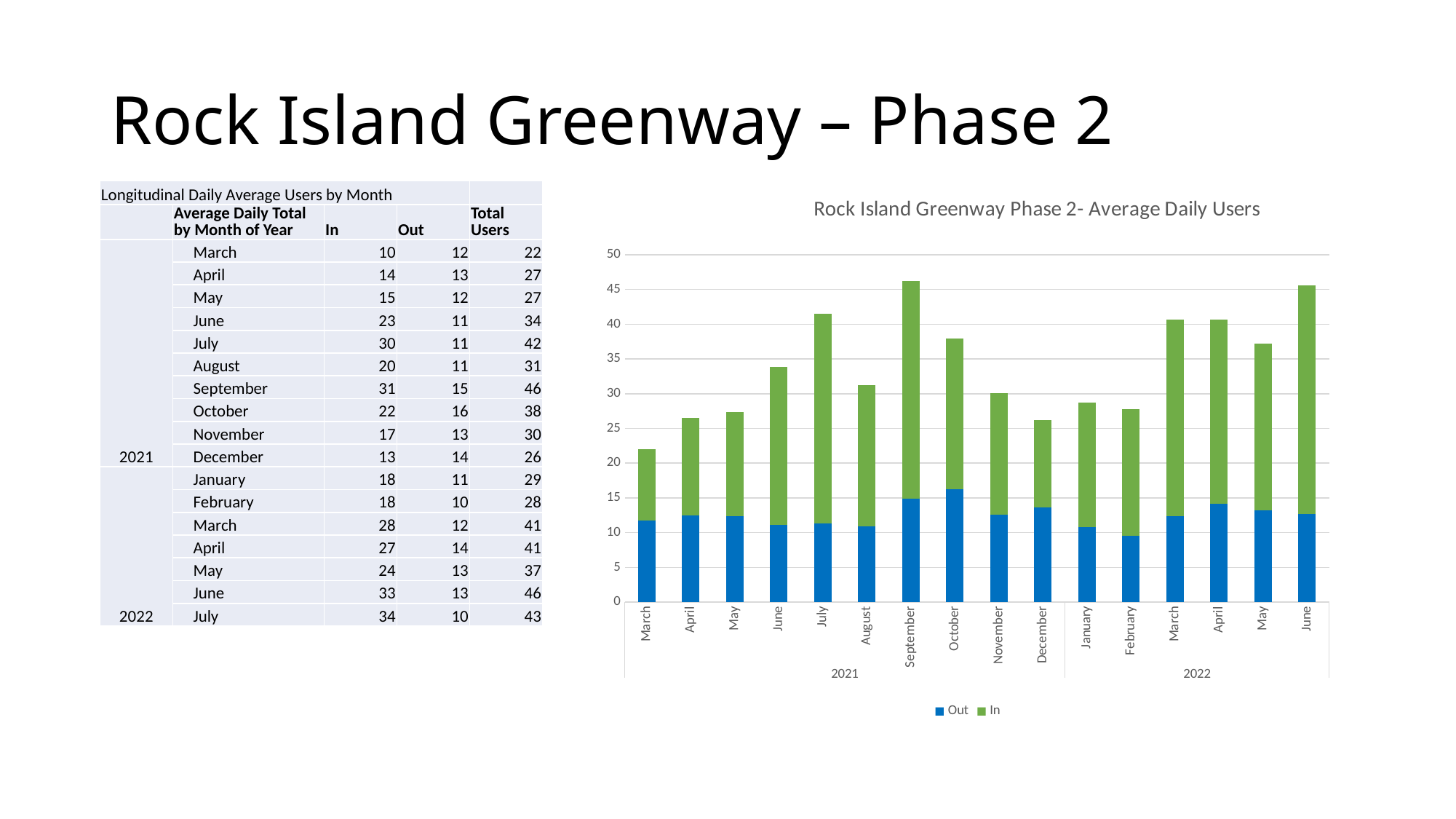
Is the total bar for September 2021 greater or less than 45? greater Is the Out value for February 2022 greater or less than 10? less Which month has the lowest total bar in the chart? March 2021 Do the total bars rise or fall from March 2021 to July 2021? rise How many series does the chart legend list? 2 Which colour represents the Out series in the chart? blue How many monthly bars are plotted in the chart? 16 Which has the taller total bar, May 2022 or June 2022? June 2022 Is the total bar for March 2021 greater or less than 25? less Which has the taller total bar, July 2021 or August 2021? July 2021 What kind of chart is shown on the slide? stacked bar chart